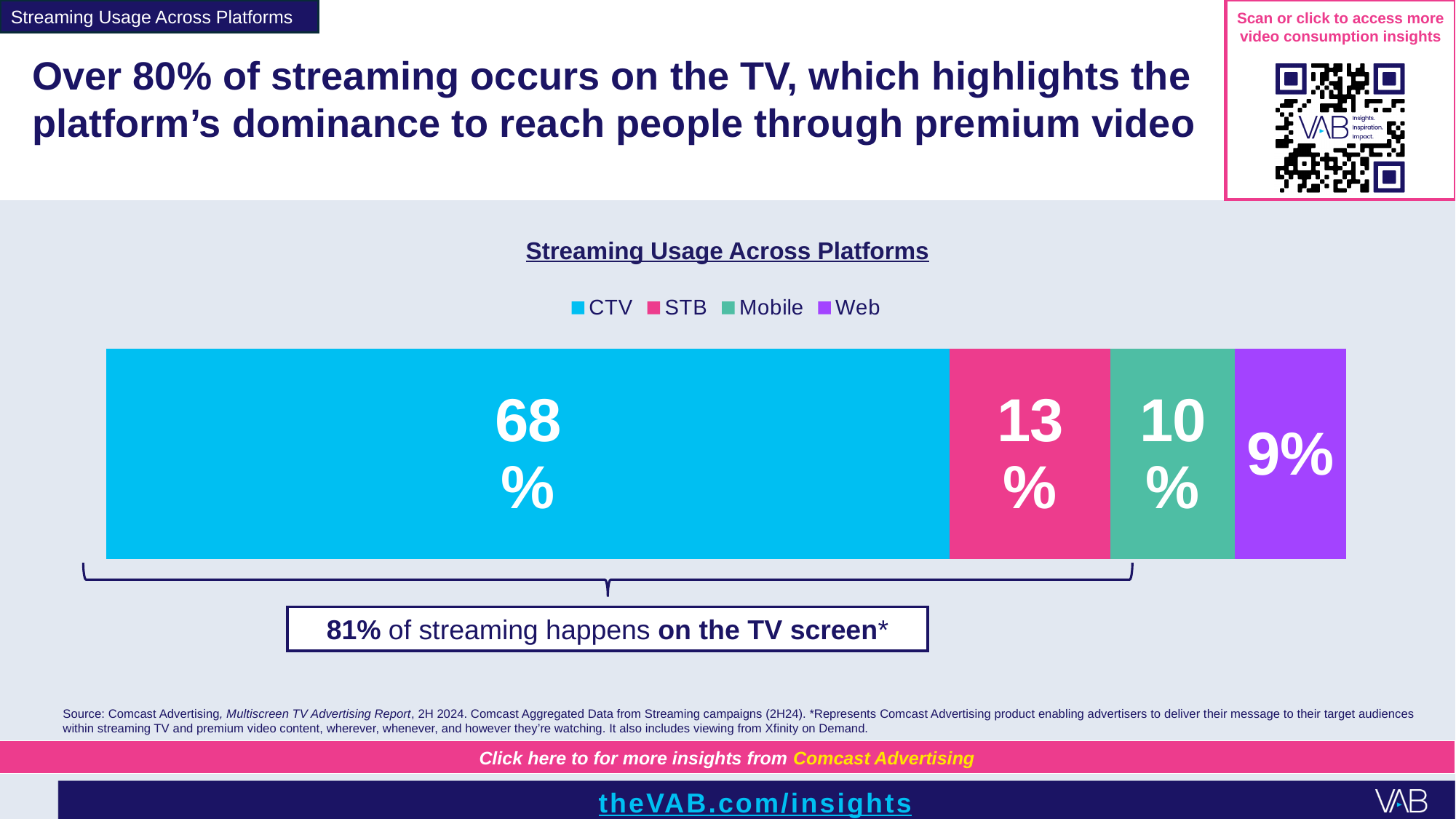
What is the value for STB in the Streaming Usage Across Platforms chart? 13% What kind of chart is shown on the slide? Stacked bar chart Which platform has the highest share of streaming usage? CTV What is the difference between the CTV and STB values? 55% Which platform has the lowest share of streaming usage? Web What colour is the CTV segment in the chart? Light blue Which is larger, the value for STB or the value for Mobile? STB What is the value for CTV in the Streaming Usage Across Platforms chart? 68% How many series does the legend list? 4 What is the value for Mobile in the Streaming Usage Across Platforms chart? 10% What is the combined total of the CTV and STB segments? 81% What is the value for Web in the Streaming Usage Across Platforms chart? 9%